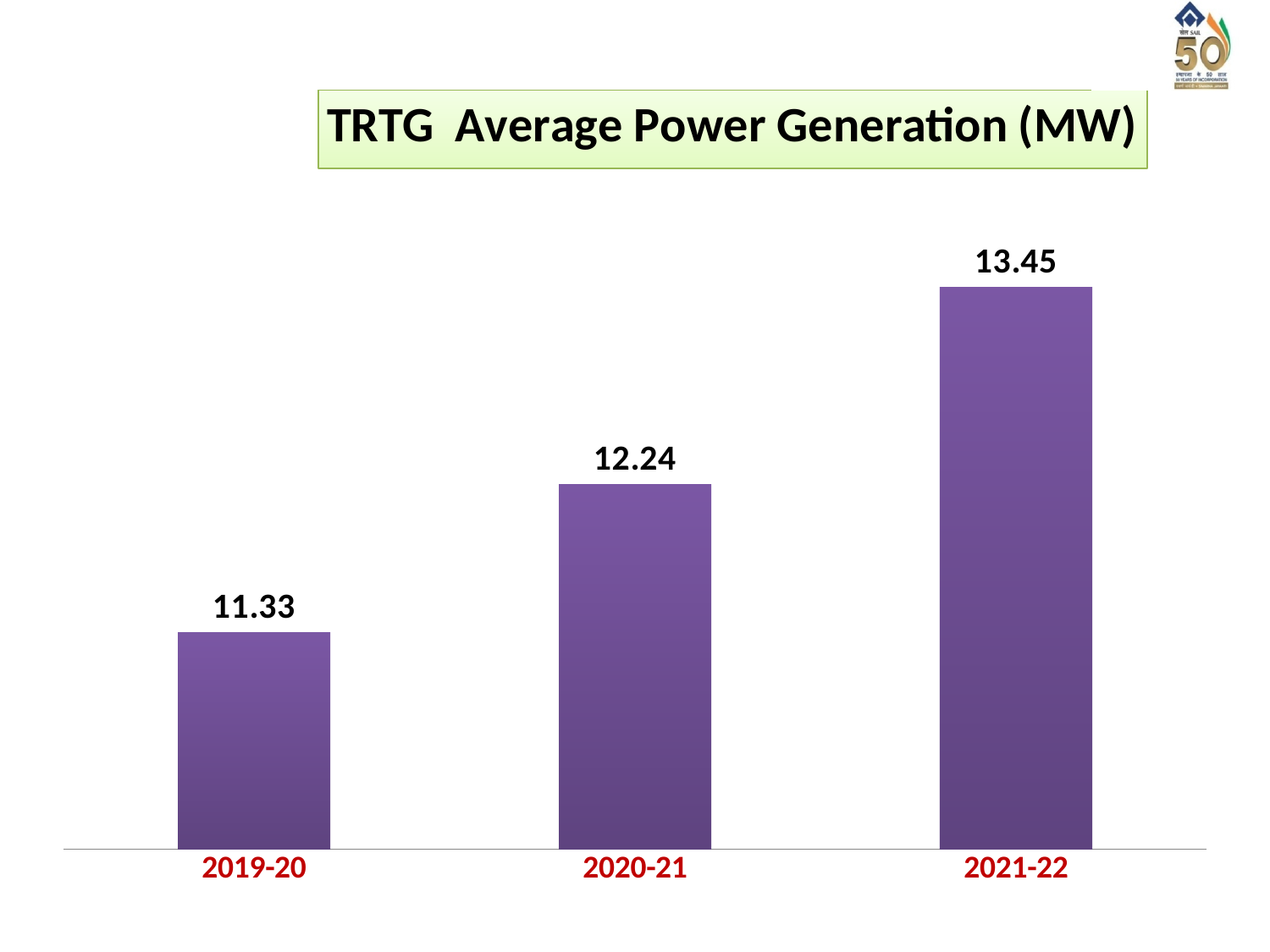
What is the title of the chart? TRTG Average Power Generation (MW) Which year has a larger TRTG average power generation, 2020-21 or 2021-22? 2021-22 How many years are shown in the chart? 3 Which year has the lowest TRTG average power generation? 2019-20 What is the TRTG average power generation for 2020-21? 12.24 What is the difference in TRTG average power generation between 2020-21 and 2019-20? 0.91 What is the TRTG average power generation for 2019-20? 11.33 Does TRTG average power generation rise or fall from 2019-20 to 2021-22? Rise What kind of chart is shown on the slide? Bar chart What is the TRTG average power generation for 2021-22? 13.45 What is the difference in TRTG average power generation between 2021-22 and 2019-20? 2.12 Which year has the highest TRTG average power generation? 2021-22